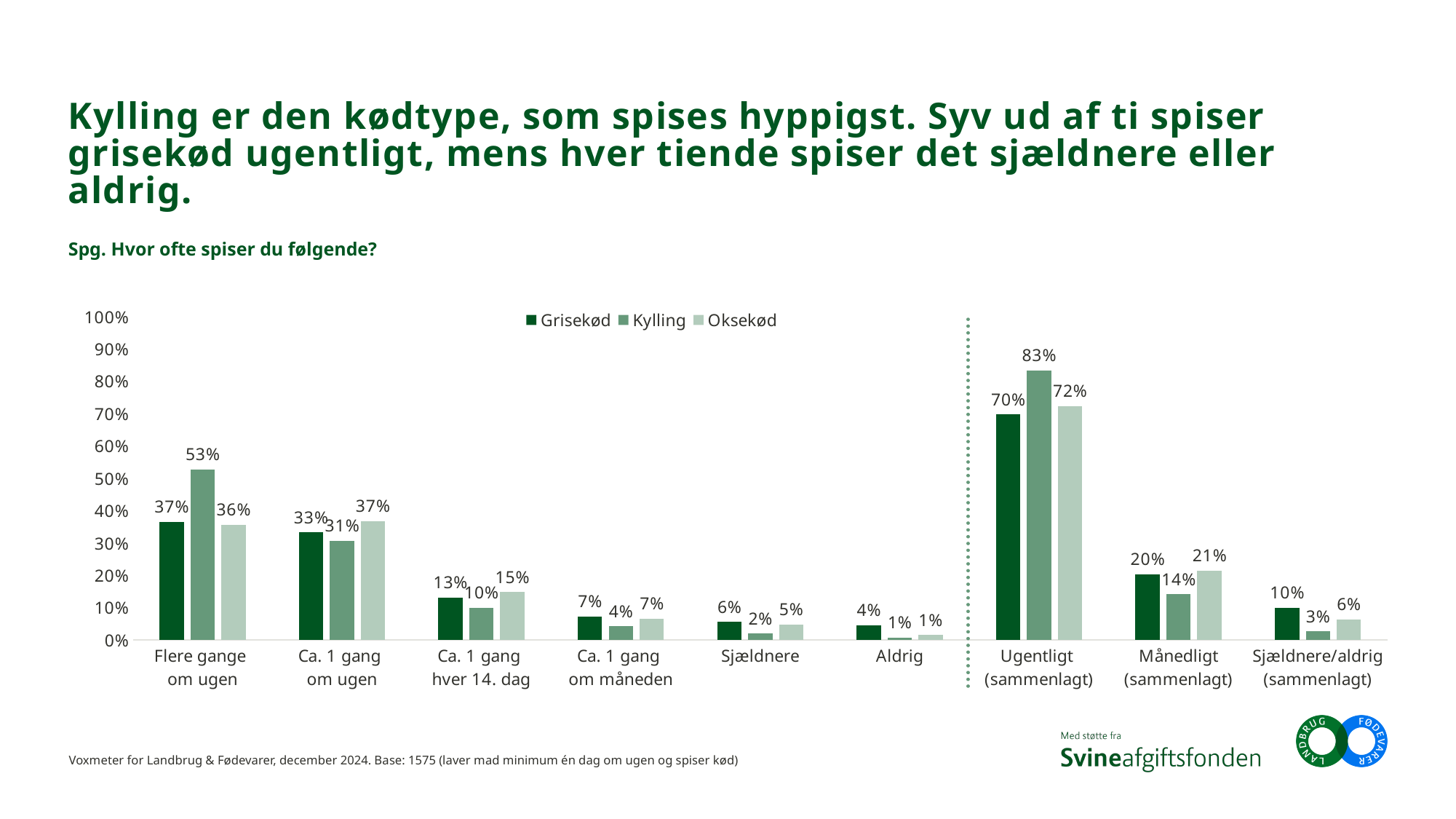
Which series has the lowest value in the 'Månedligt (sammenlagt)' category? Kylling Is the value for Oksekød in 'Ugentligt (sammenlagt)' greater or less than 60%? greater Which series has the highest value in the 'Ugentligt (sammenlagt)' category? Kylling What kind of chart is shown on the slide? Bar chart How many categories are shown on the x axis? 9 What is the value for Grisekød in the 'Ugentligt (sammenlagt)' category? 70% How many series does the legend list? 3 What is the question text shown above the chart? Spg. Hvor ofte spiser du følgende? What is the value for Oksekød in the 'Ca. 1 gang hver 14. dag' category? 15% Which is larger in the 'Sjældnere/aldrig (sammenlagt)' category: Grisekød or Oksekød? Grisekød What is the difference between Kylling and Grisekød in the 'Ugentligt (sammenlagt)' category? 13% What is the value for Kylling in the 'Flere gange om ugen' category? 53%